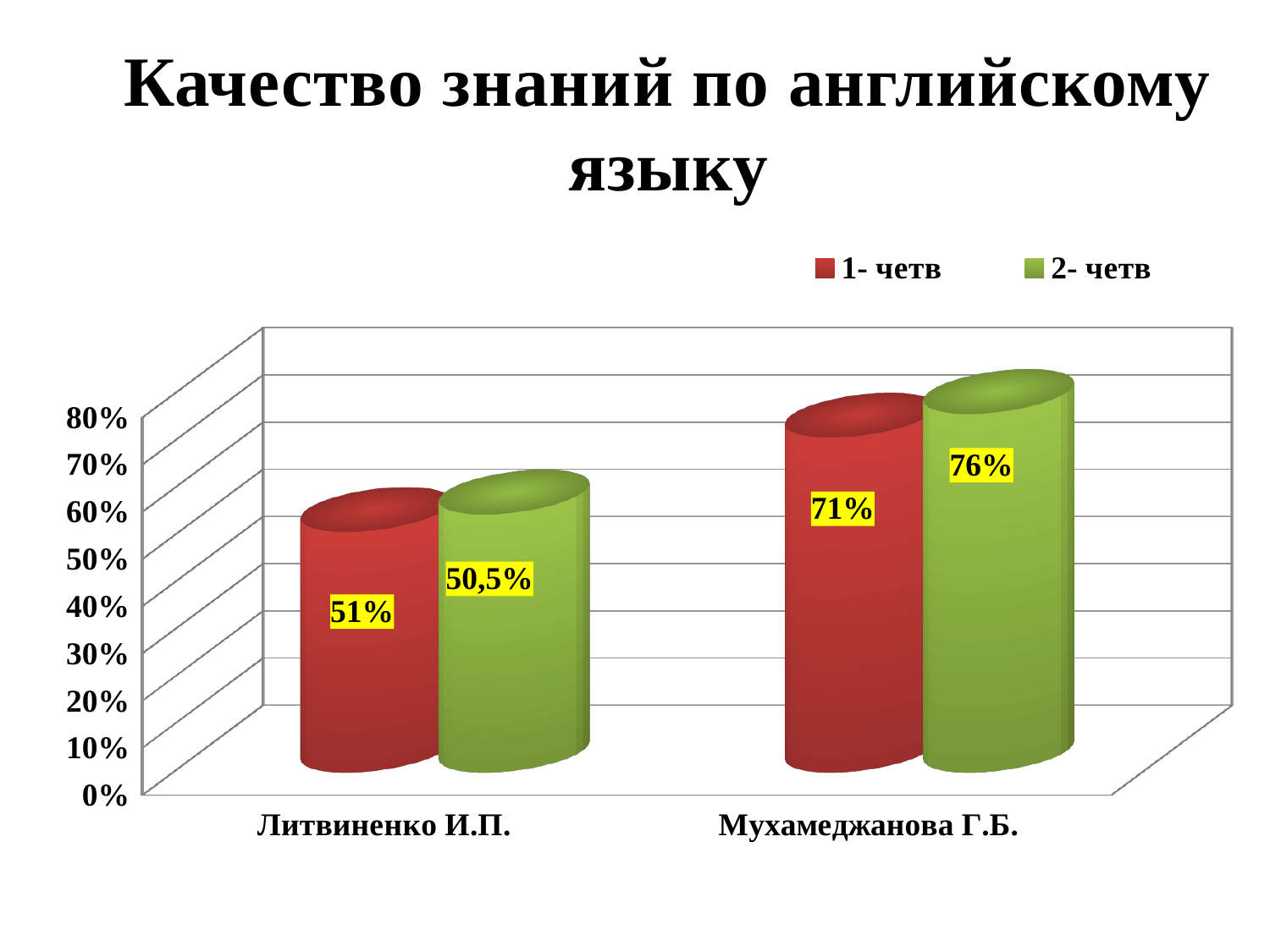
What is the value for Мухамеджанова Г.Б. in the 1- четв series? 71% Which teacher has the lowest value in the 1- четв series? Литвиненко И.П. Which is larger for Мухамеджанова Г.Б.: the 1- четв value or the 2- четв value? 2- четв What is the difference between the 2- четв and 1- четв values for Мухамеджанова Г.Б.? 5% What is the value for Мухамеджанова Г.Б. in the 2- четв series? 76% How many series does the legend list? 2 Which teacher has the highest value in the 2- четв series? Мухамеджанова Г.Б. How many teachers (categories) are shown on the x axis? 2 What is the value for Литвиненко И.П. in the 1- четв series? 51% What is the difference between the 1- четв values for Мухамеджанова Г.Б. and Литвиненко И.П.? 20% What kind of chart is shown on the slide? Bar chart What is the value for Литвиненко И.П. in the 2- четв series? 50,5%